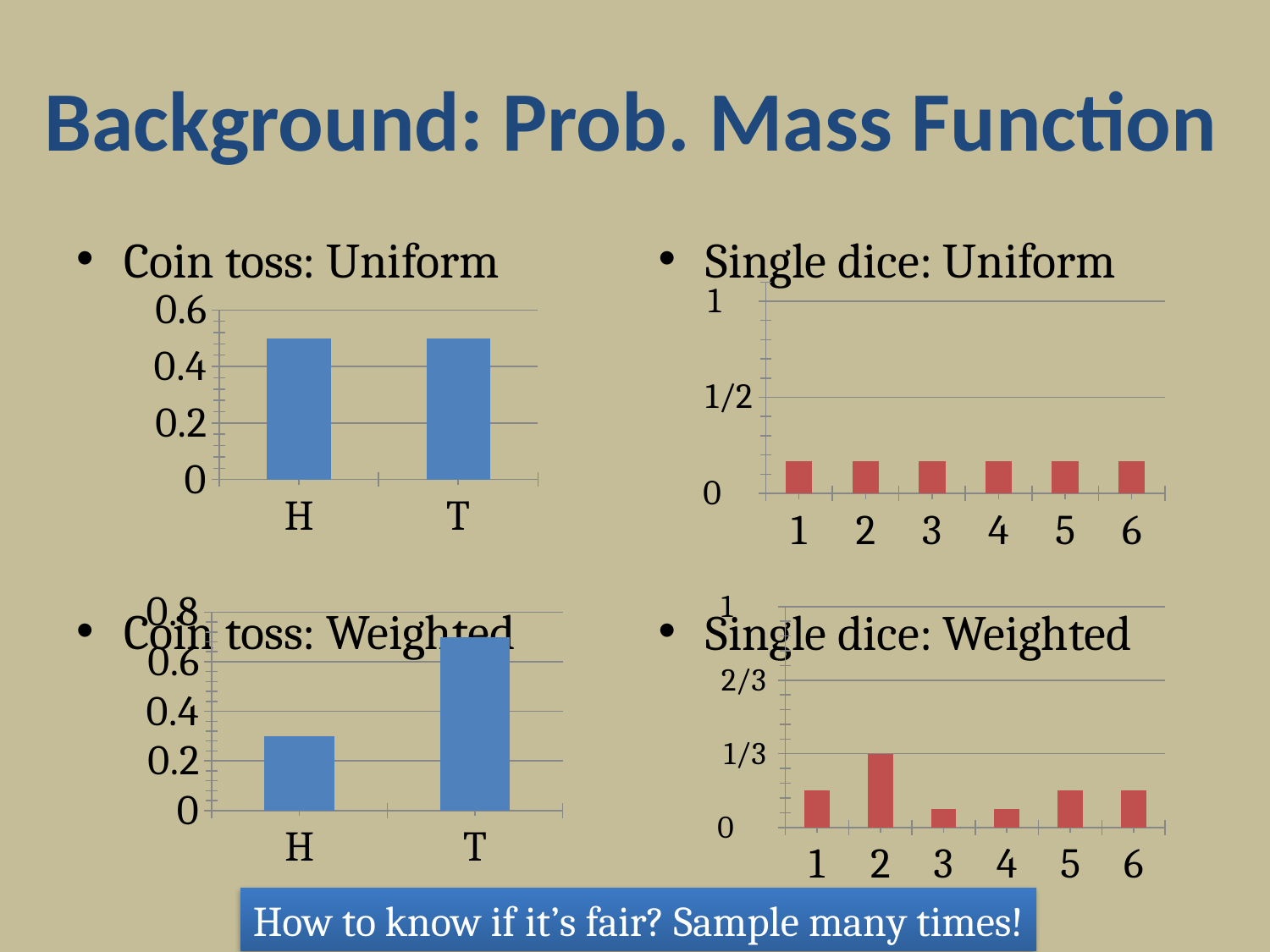
In the "Coin toss: Weighted" chart, is the value for T greater or less than 0.6? greater In the "Coin toss: Weighted" chart, which category has the highest value? T In the "Single dice: Uniform" chart, is the value for 3 greater or less than 1/2? less How many categories are shown on the x axis of the "Coin toss: Weighted" chart? 2 In the "Single dice: Weighted" chart, which is larger, the value for 1 or the value for 3? 1 In the "Coin toss: Weighted" chart, which category has the lowest value? H How many categories are shown on the x axis of the "Single dice: Uniform" chart? 6 In the "Coin toss: Weighted" chart, is the value for H greater or less than 0.4? less In the "Single dice: Weighted" chart, which category has the highest value? 2 What kind of chart is the "Coin toss: Uniform" chart? bar chart